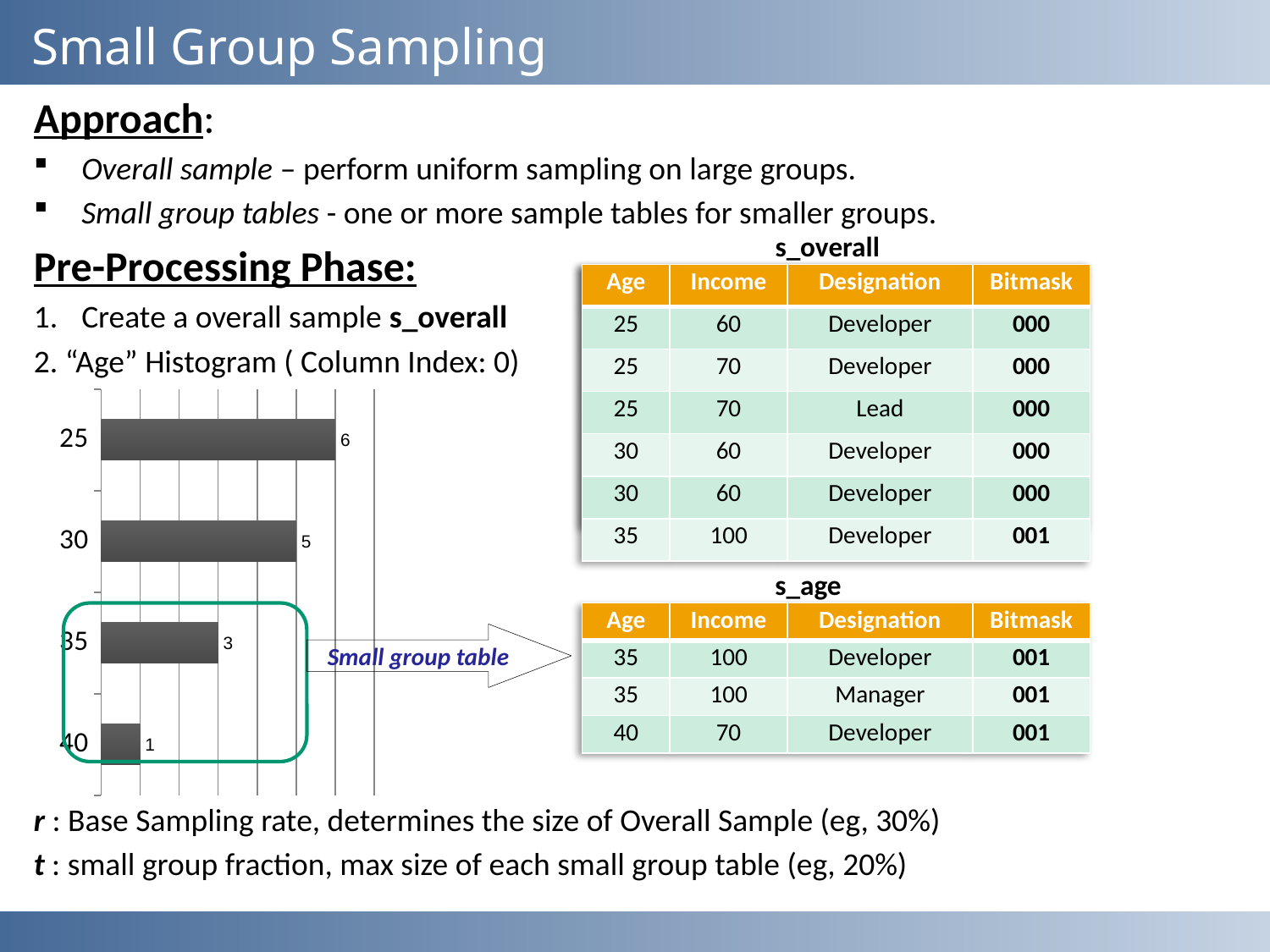
What is the difference between the values for age 30 and age 35 in the Age histogram? 2 What is the value for age 40 in the Age histogram? 1 Which age group has the lowest value in the Age histogram? 40 What is the value for age 30 in the Age histogram? 5 What is the value for age 35 in the Age histogram? 3 Which age group has the highest value in the Age histogram? 25 What is the difference between the values for age 25 and age 40 in the Age histogram? 5 What is the value for age 25 in the Age histogram? 6 What kind of chart is the Age histogram? bar chart Which has a larger value in the Age histogram, age 30 or age 35? 30 How many age categories are shown in the Age histogram? 4 Do the values in the Age histogram rise or fall as age increases from 25 to 40? fall